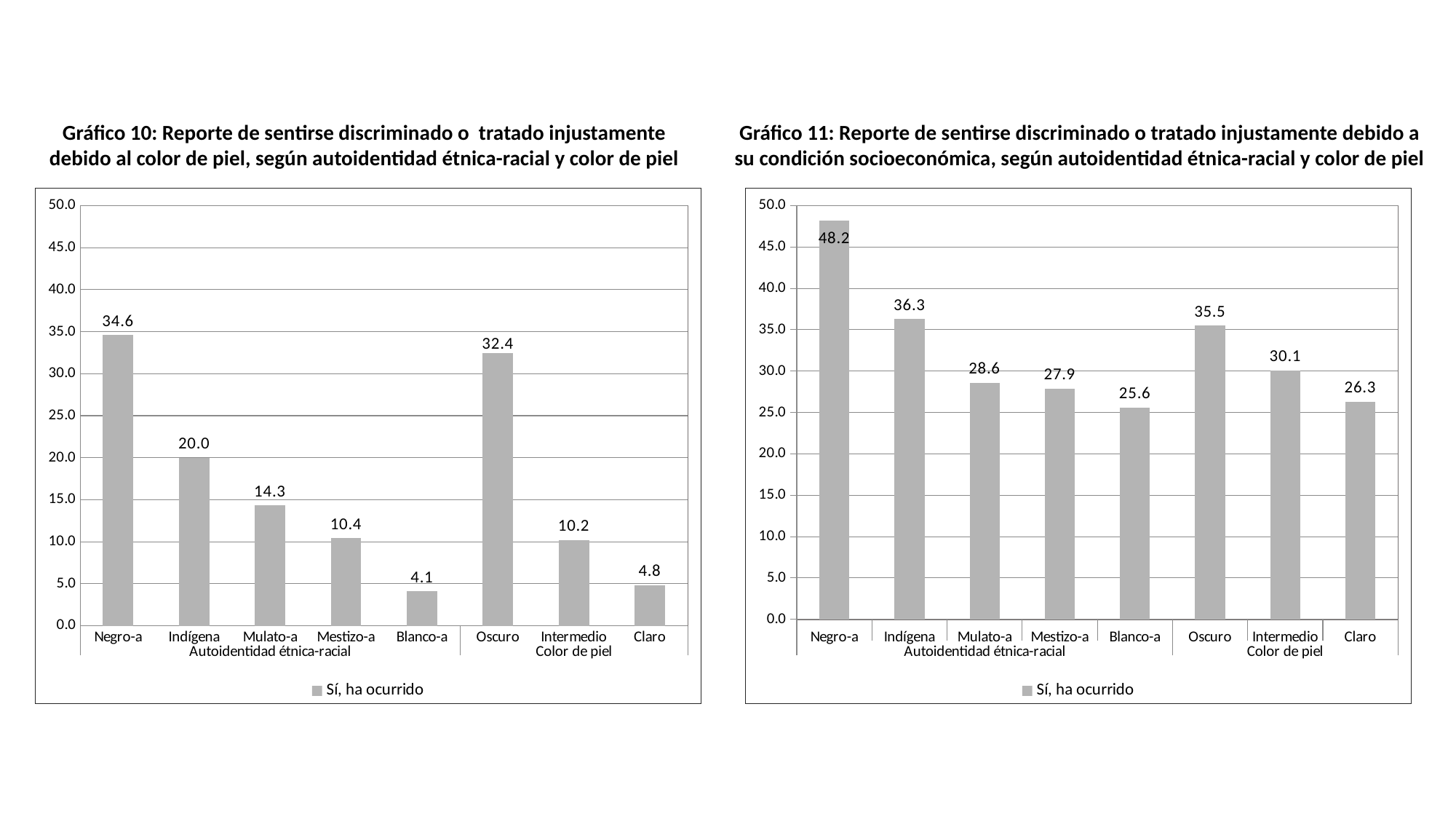
In Gráfico 11 (right chart), is the value for Mestizo-a greater or less than 30.0? less In Gráfico 10 (left chart), which is larger, the value for Mulato-a or the value for Mestizo-a? Mulato-a What kind of chart is Gráfico 10 (left chart)? Bar chart In Gráfico 11 (right chart), which category has the highest value? Negro-a In Gráfico 10 (left chart), what is the value for Negro-a? 34.6 In Gráfico 10 (left chart), which category has the lowest value? Blanco-a In Gráfico 11 (right chart), what is the value for Intermedio? 30.1 In Gráfico 11 (right chart), how many series does the legend list? 1 In Gráfico 10 (left chart), how many categories are plotted? 8 In Gráfico 11 (right chart), what is the difference between the values for Negro-a and Indígena? 11.9 In Gráfico 10 (left chart), what is the difference between the values for Oscuro and Claro? 27.6 In Gráfico 11 (right chart), which category has the lowest value? Blanco-a